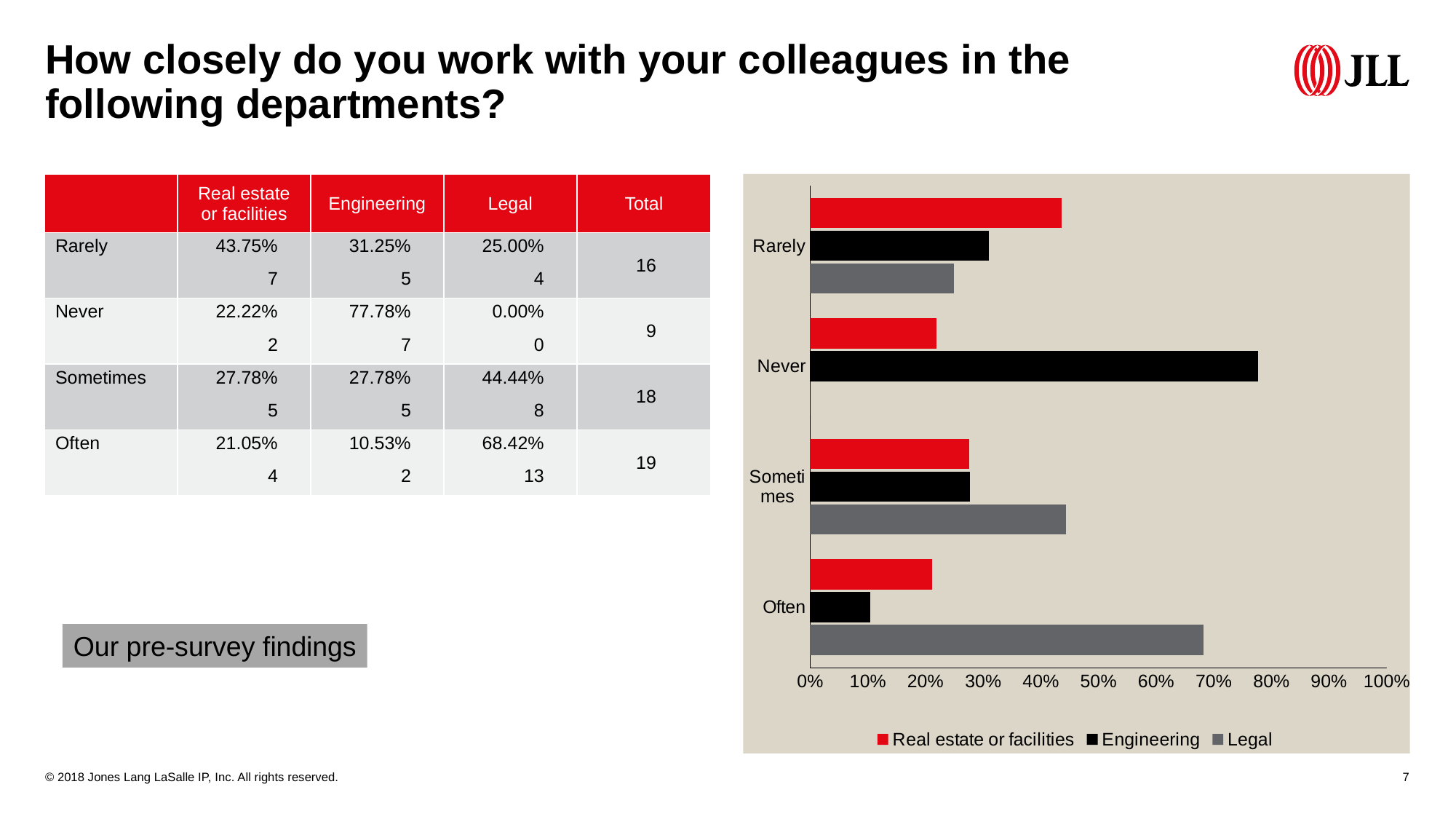
What colour represents the Legal series in the chart? grey Is the value for Engineering in the Often category greater or less than 20%? less What kind of chart is shown on the slide? bar chart What is the value for Real estate or facilities in the Sometimes category? 27.78% In the Rarely category, which is larger: Real estate or facilities or Engineering? Real estate or facilities Which category has the highest value for Engineering? Never What is the value for Legal in the Often category? 68.42% Which category has the lowest value for Legal? Never In the Never category, what is the difference between the Engineering value and the Real estate or facilities value? 55.56% How many series does the chart's legend list? 3 Is the value for Legal in the Sometimes category greater or less than 40%? greater How many categories are shown on the chart's vertical axis? 4